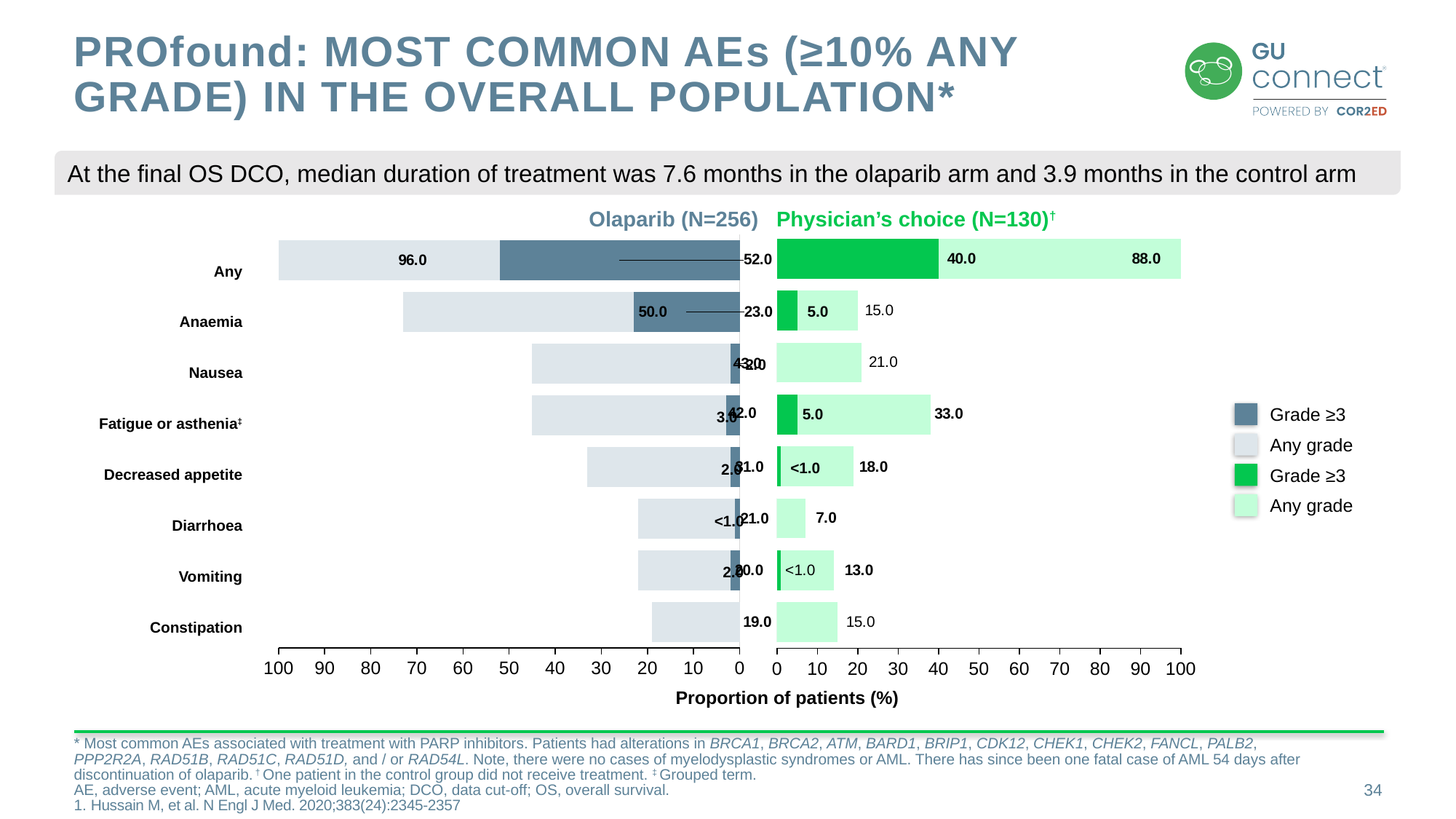
What is the any-grade value for Fatigue or asthenia in the Physician's choice arm? 33.0 What is the Grade ≥3 value for 'Any' adverse event in the Physician's choice (N=130) arm? 40.0 What is the any-grade value for 'Any' adverse event in the Olaparib (N=256) arm? 96.0 How many entries does the legend list? 4 What is the any-grade value for Anaemia in the Olaparib arm? 50.0 How many adverse event categories are listed on the chart? 8 What is the any-grade value for Constipation in the Olaparib arm? 19.0 What kind of chart is shown on the slide? Bar chart What is the Grade ≥3 value for Anaemia in the Olaparib arm? 23.0 What is the difference between the any-grade 'Any' adverse event values for the Olaparib arm (96.0) and the Physician's choice arm (88.0)? 8.0 Which arm has the higher any-grade value for Anaemia, Olaparib or Physician's choice? Olaparib Which adverse event category has the lowest any-grade value in the Physician's choice arm? Diarrhoea